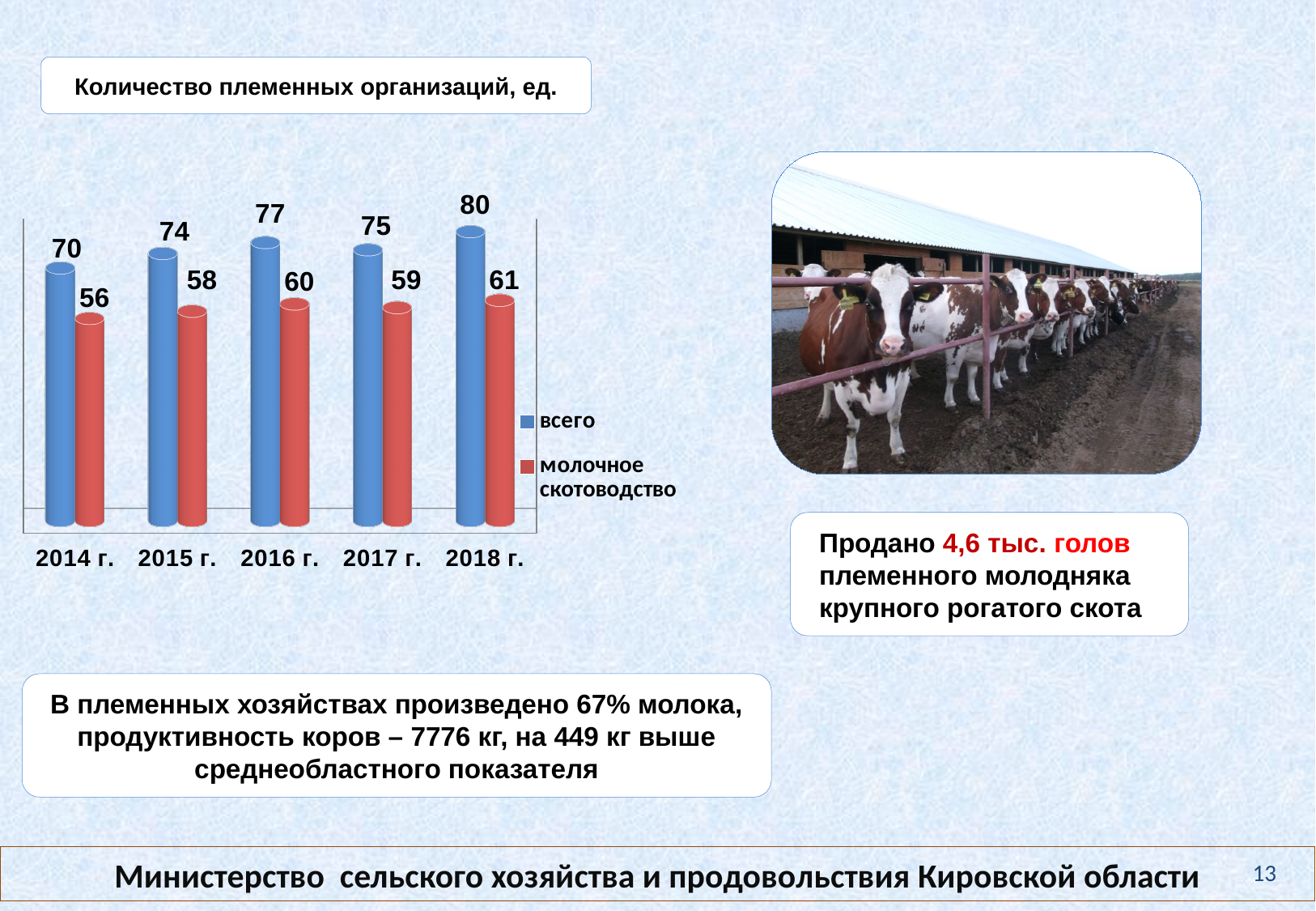
In which year is the value for "молочное скотоводство" lowest? 2014 г. What is the value for "всего" in 2016 г.? 77 What kind of chart is shown on the slide? bar chart Which is larger: "всего" in 2015 г. or "всего" in 2017 г.? всего in 2017 г. In which year is the value for "всего" highest? 2018 г. What is the value for "молочное скотоводство" in 2018 г.? 61 What is the value for "молочное скотоводство" in 2014 г.? 56 By how much did the value for "всего" increase from 2014 г. to 2018 г.? 10 What is the difference between "всего" and "молочное скотоводство" in 2017 г.? 16 What is the title of the chart? Количество племенных организаций, ед. How many years are shown on the x axis? 5 How many series does the legend list? 2